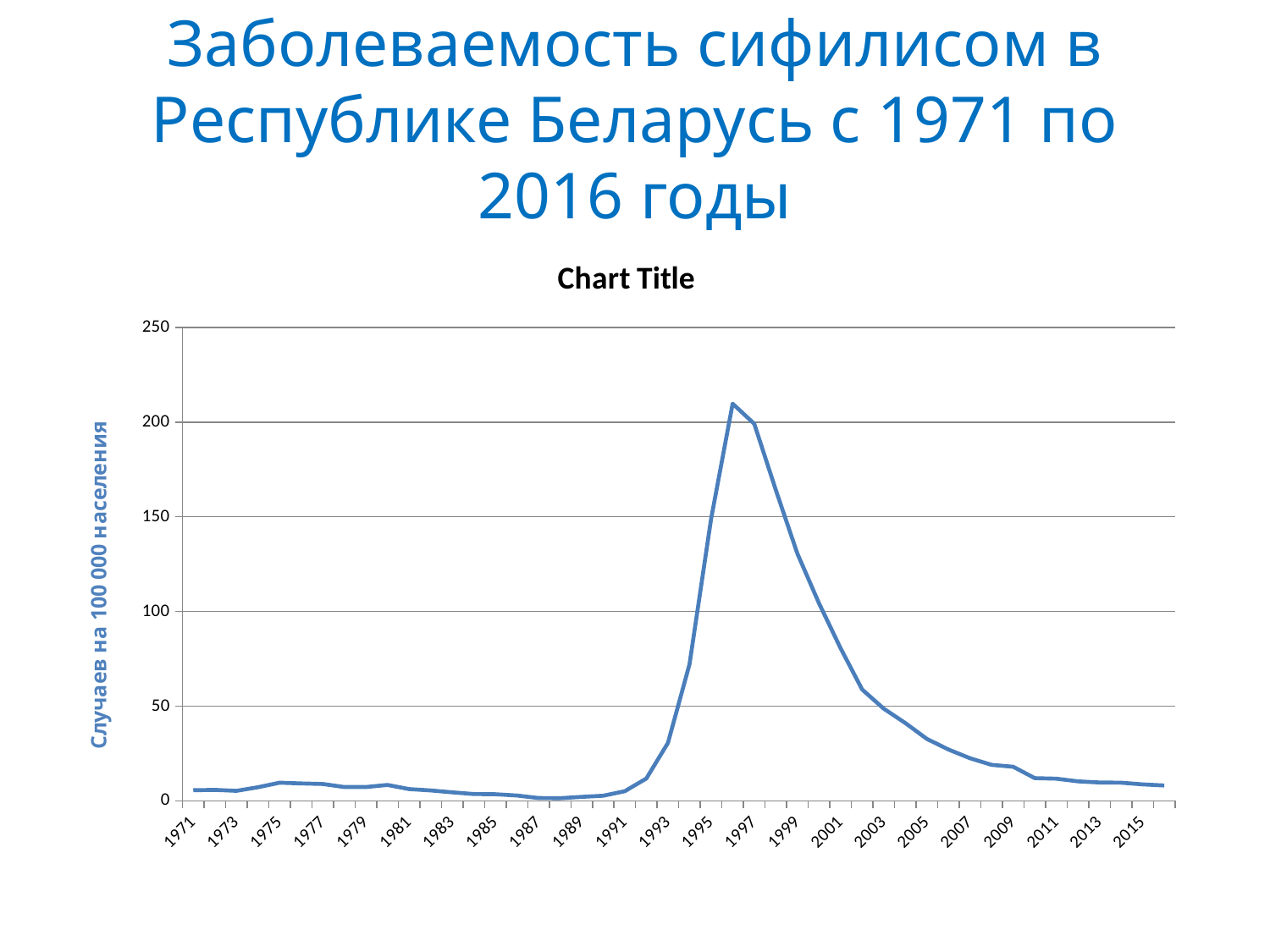
Do the values rise or fall from 1997 to 2015? fall Is the value for 1975 greater or less than 50? less Is the value for 1999 greater or less than 150? less What kind of chart is shown on the slide? line chart Is the value for 1993 greater or less than 50? less What is the title of the vertical axis? Случаев на 100 000 населения Which year has the larger value, 1975 or 1993? 1993 Which year has the larger value, 1999 or 2005? 1999